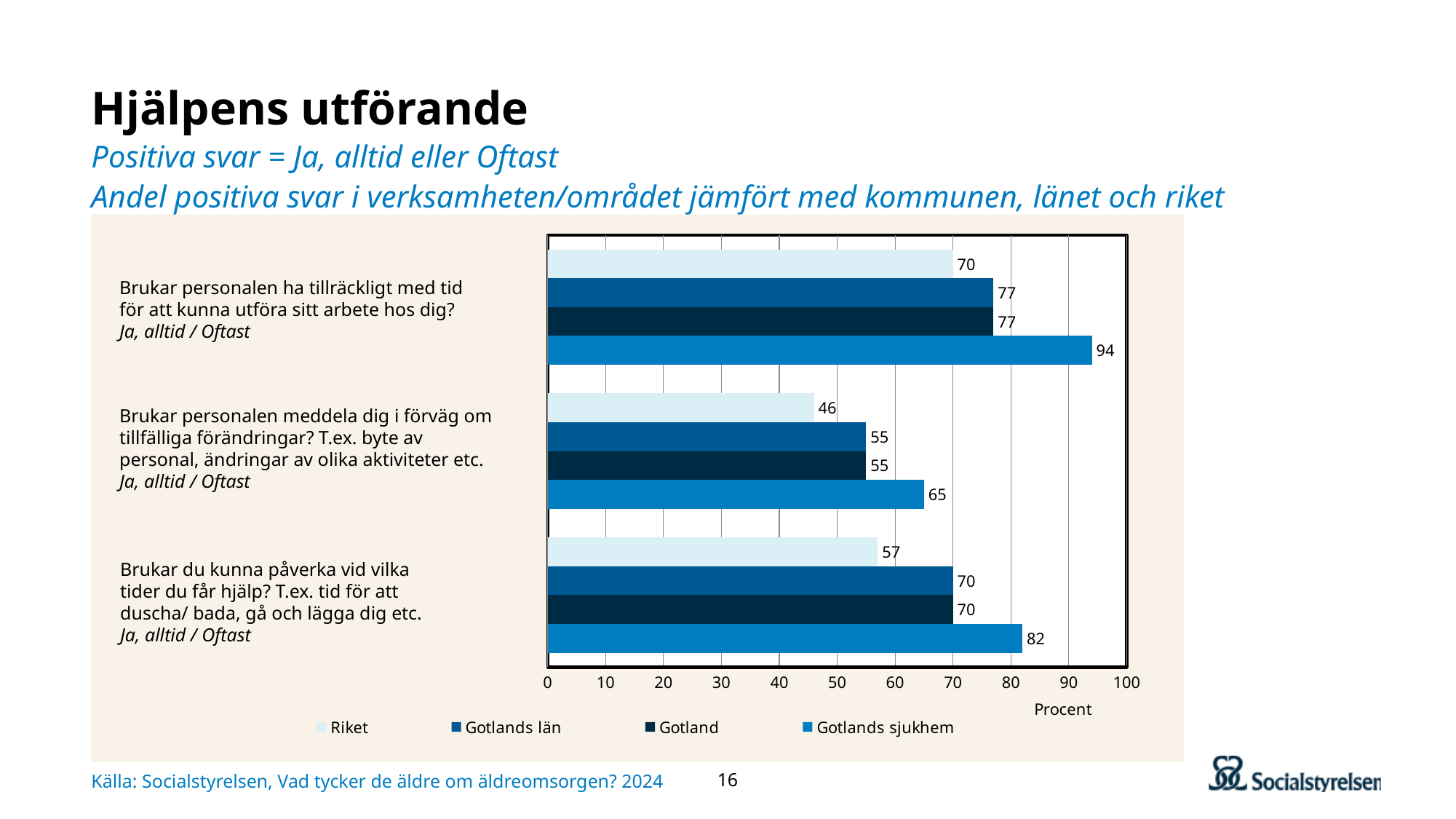
What is the value for Gotlands sjukhem for the question "Brukar personalen ha tillräckligt med tid för att kunna utföra sitt arbete hos dig?"? 94 Which series has the lowest value for the question "Brukar personalen meddela dig i förväg om tillfälliga förändringar?"? Riket What is the difference between Gotlands sjukhem and Riket for the question "Brukar personalen ha tillräckligt med tid för att kunna utföra sitt arbete hos dig?"? 24 How many series does the legend list? 4 What unit is shown on the x axis of the chart? Procent How many question categories are shown in the chart? 3 What kind of chart is shown on the slide? Bar chart Which series has the highest value for the question "Brukar du kunna påverka vid vilka tider du får hjälp?"? Gotlands sjukhem What is the value for Gotland for the question "Brukar du kunna påverka vid vilka tider du får hjälp?"? 70 Which is larger: the Gotlands län value for "Brukar personalen meddela dig i förväg om tillfälliga förändringar?" or the Riket value for "Brukar du kunna påverka vid vilka tider du får hjälp?"? Riket value for "Brukar du kunna påverka vid vilka tider du får hjälp?" What is the value for Riket for the question "Brukar personalen meddela dig i förväg om tillfälliga förändringar?"? 46 What is the difference between Gotlands sjukhem and Gotland for the question "Brukar personalen meddela dig i förväg om tillfälliga förändringar?"? 10